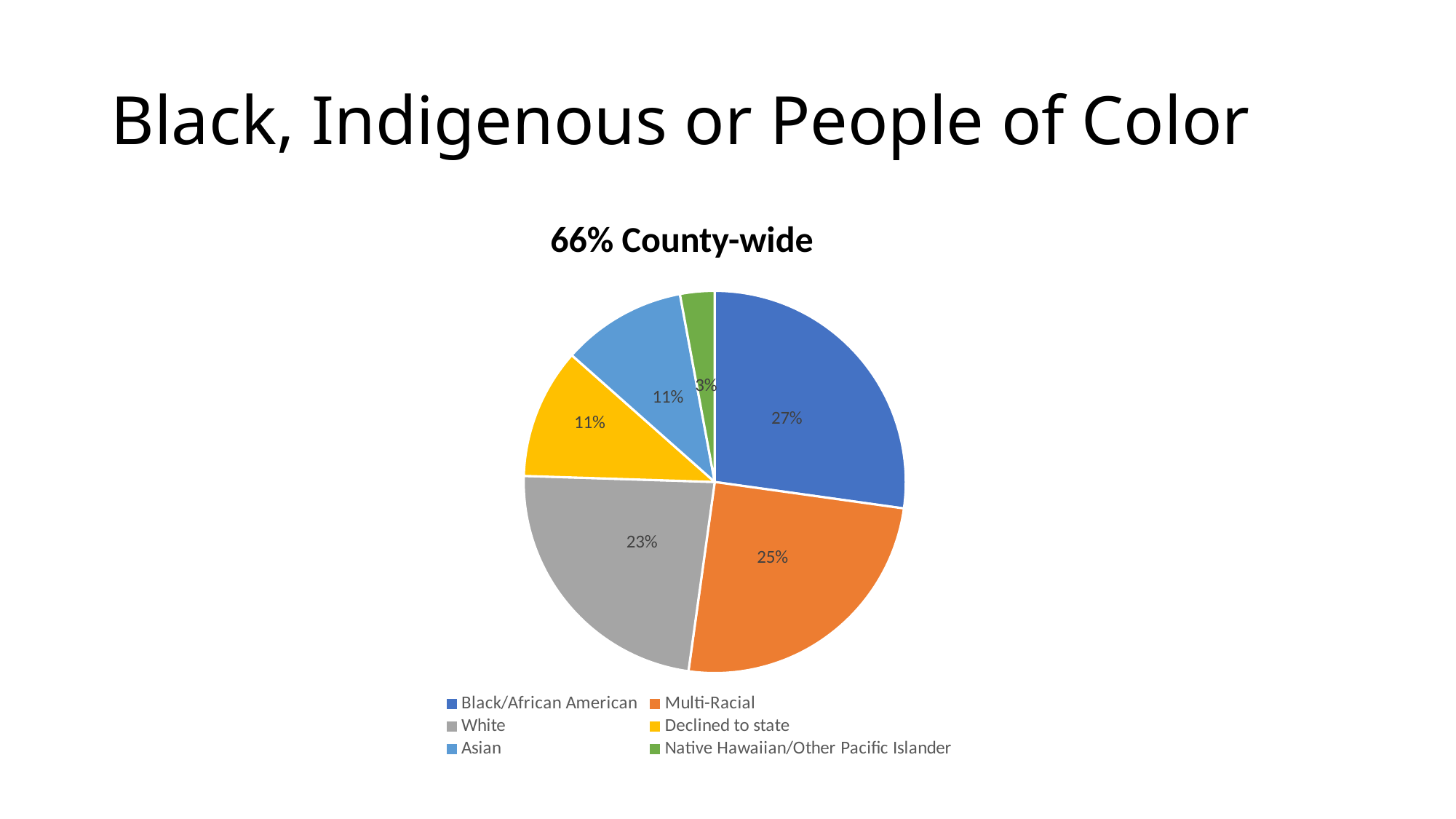
What is the title of the chart? 66% County-wide Which colour represents Declined to state in the pie chart? Yellow What share of the pie does Multi-Racial represent? 25% What share of the pie does Black/African American represent? 27% Which category has the smallest slice of the pie? Native Hawaiian/Other Pacific Islander Which slice is larger, Multi-Racial or Asian? Multi-Racial What share of the pie does Native Hawaiian/Other Pacific Islander represent? 3% How many categories does the pie chart show? 6 Which category has the largest slice of the pie? Black/African American What is the difference in percentage points between the Black/African American slice and the White slice? 4% What kind of chart is shown on the slide? Pie chart